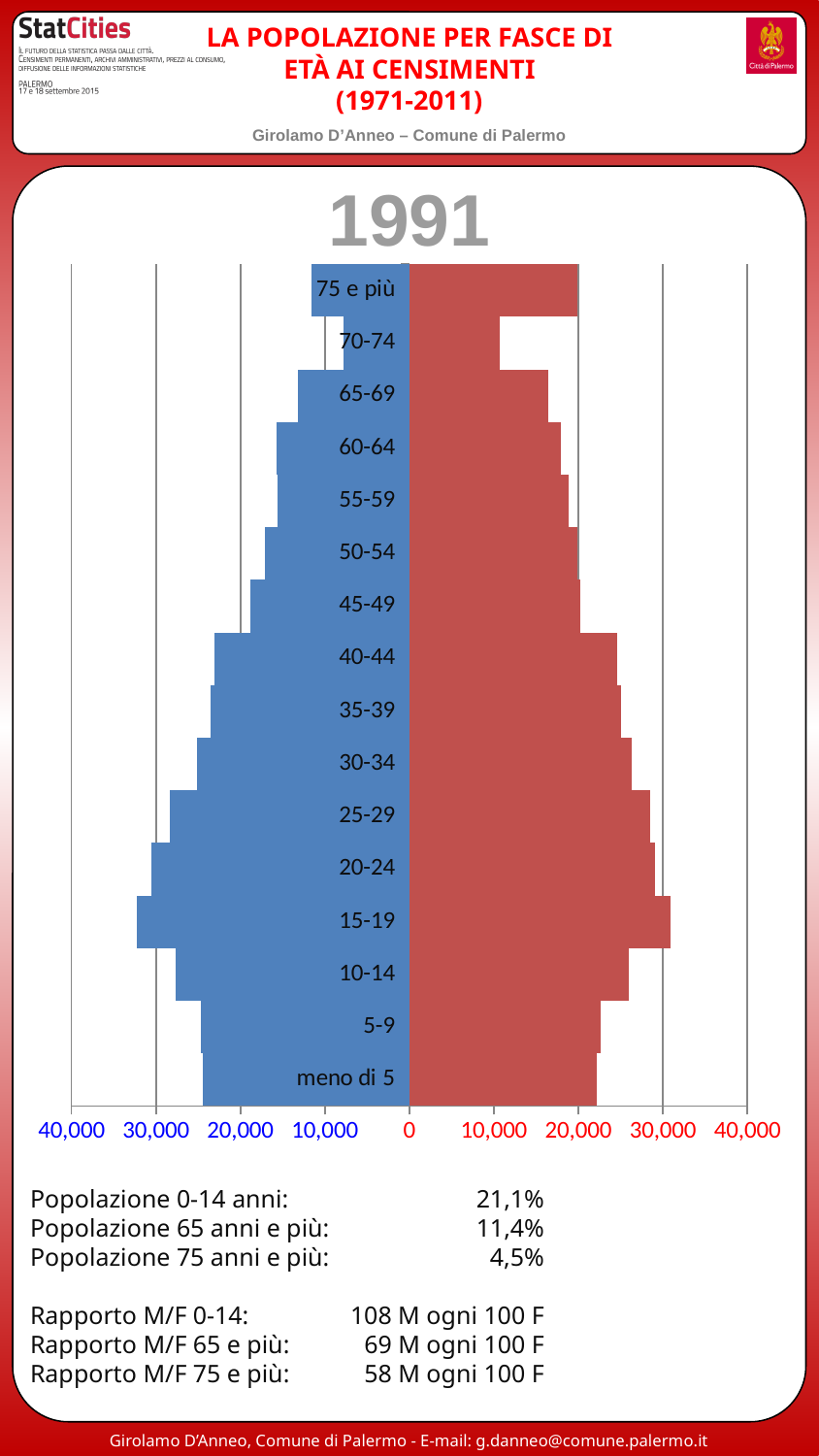
Moving up from the 15-19 age group to 75 e più, do the bars on the left (blue) side generally get longer or shorter? shorter Is the value of the left (blue) bar for 15-19 greater or less than 30,000? greater Is the value of the left (blue) bar for 60-64 greater or less than 20,000? less Which age group has the longest bar on the left (blue) side of the chart? 15-19 Which age group has the shortest bar on the left (blue) side of the chart? 70-74 Is the value of the left (blue) bar for 70-74 greater or less than 10,000? less How many age groups are shown on the chart? 16 Which age group has the longest bar on the right (red) side of the chart? 15-19 On the left (blue) side, which bar is longer: 20-24 or 60-64? 20-24 What kind of chart is used to show the population by age group? bar chart (population pyramid) What year is shown as the title of the population pyramid chart? 1991